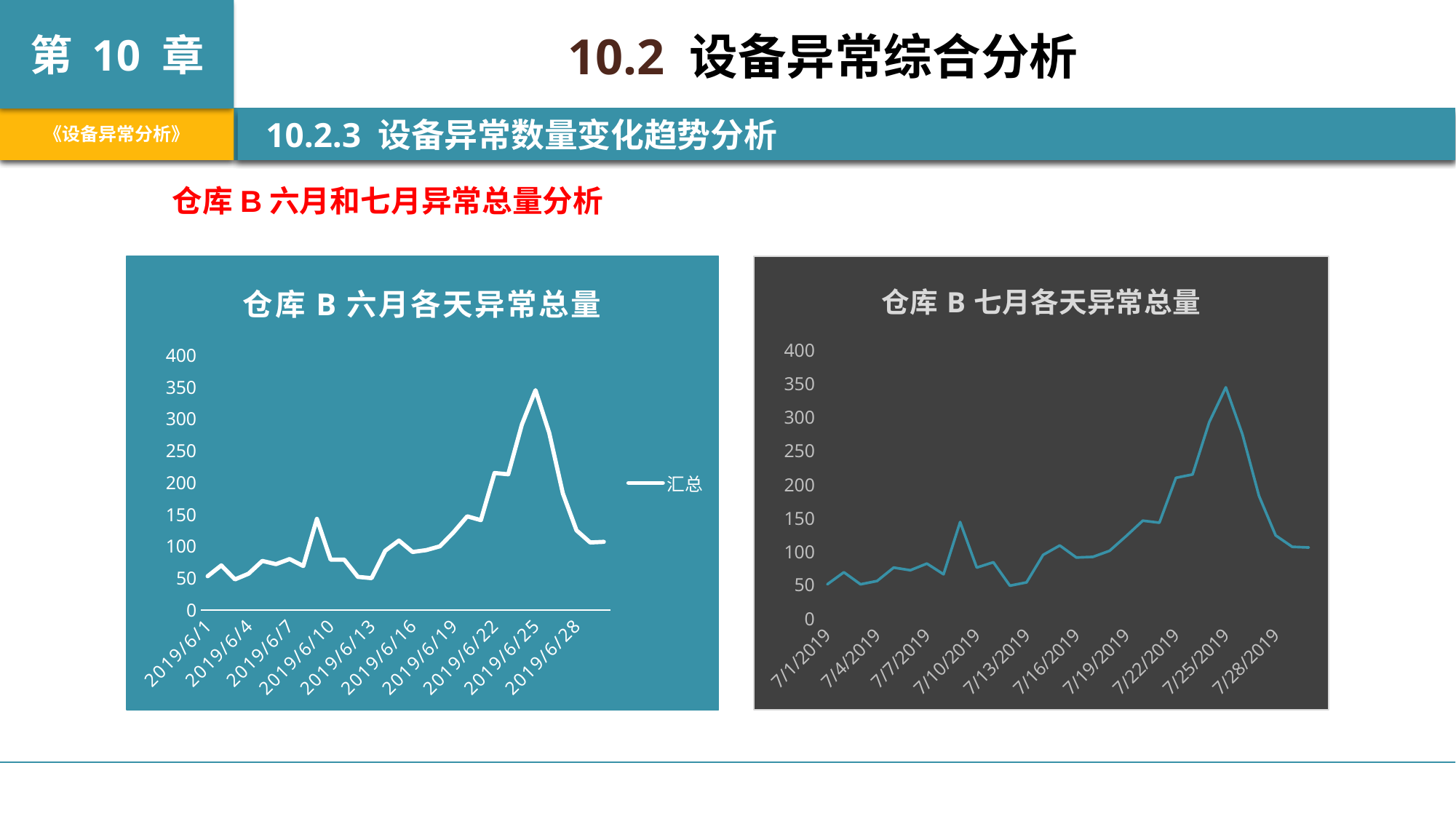
In the right chart (仓库 B 七月各天异常总量), is the value for 7/25/2019 greater or less than 300? greater In the left chart (仓库 B 六月各天异常总量), is the value for 2019/6/1 greater or less than 100? less In the left chart (仓库 B 六月各天异常总量), how many series does the legend list? 1 In the left chart (仓库 B 六月各天异常总量), is the peak value at 2019/6/25 greater or less than 300? greater What is the title of the right chart on the slide? 仓库 B 七月各天异常总量 In the left chart (仓库 B 六月各天异常总量), does the line rise or fall between 2019/6/25 and 2019/6/28? fall In the left chart (仓库 B 六月各天异常总量), what is the legend entry for the plotted line? 汇总 What kind of chart is the left chart titled 仓库 B 六月各天异常总量? line chart In the right chart (仓库 B 七月各天异常总量), does the line rise or fall between 7/19/2019 and 7/25/2019? rise In the left chart (仓库 B 六月各天异常总量), on which date does the line reach its highest value? 2019/6/25 In the right chart (仓库 B 七月各天异常总量), on which date does the line reach its highest value? 7/25/2019